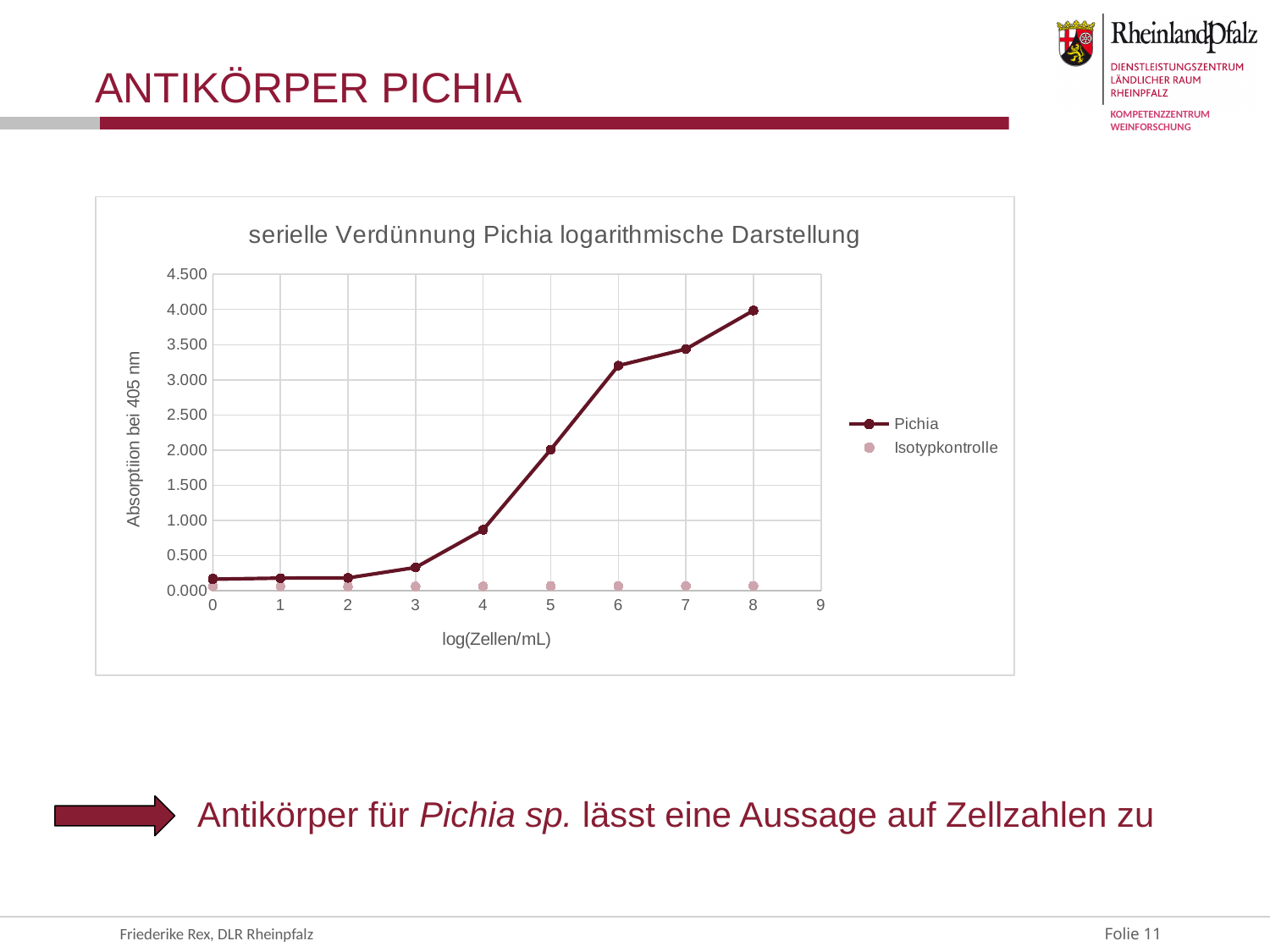
What are the names of the two series in the legend? Pichia and Isotypkontrolle At which log(Zellen/mL) value is the Pichia absorption highest? 8 What kind of chart is shown on the slide? line chart Is the Pichia value at log(Zellen/mL) = 4 greater or less than 1.000? less Is the Pichia value at log(Zellen/mL) = 3 greater or less than 0.500? less Do the Pichia values rise or fall as log(Zellen/mL) increases? rise Is the Pichia value at log(Zellen/mL) = 6 greater or less than 3.000? greater How many series does the legend list? 2 What is the title of the chart? serielle Verdünnung Pichia logarithmische Darstellung Which is larger for the Pichia series: the value at log(Zellen/mL) = 6 or at log(Zellen/mL) = 4? log(Zellen/mL) = 6 Which series has the larger value at log(Zellen/mL) = 5, Pichia or Isotypkontrolle? Pichia